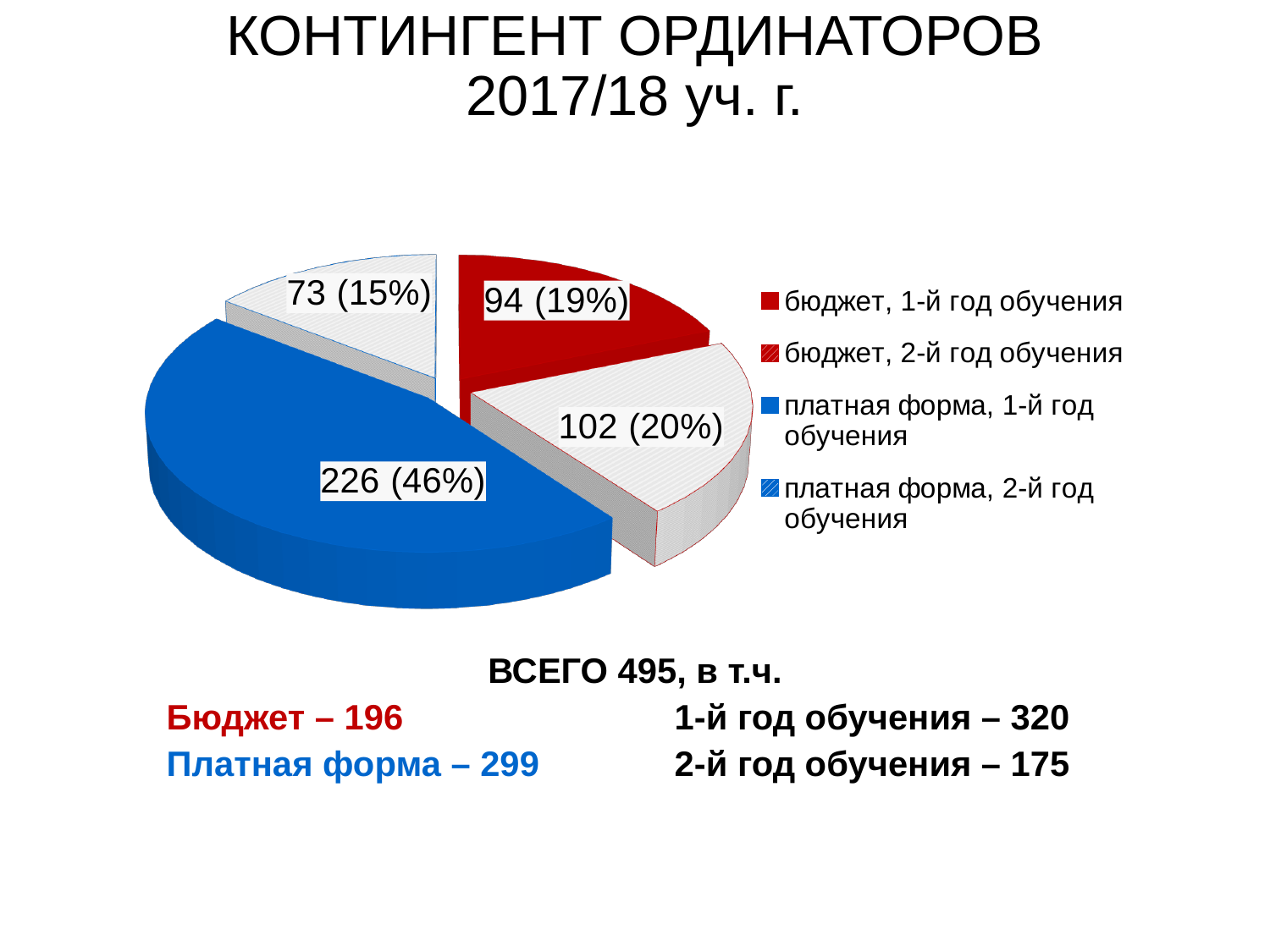
Which is larger: the value for "бюджет, 2-й год обучения" or "бюджет, 1-й год обучения"? бюджет, 2-й год обучения Which category has the largest slice? платная форма, 1-й год обучения How many slices does the pie chart have? 4 Which category has the smallest slice? платная форма, 2-й год обучения What kind of chart is shown on the slide? pie chart What is the value for "платная форма, 2-й год обучения"? 73 What is the difference between the values for "платная форма, 1-й год обучения" and "бюджет, 2-й год обучения"? 124 What share of the pie does "платная форма, 1-й год обучения" take? 46% What is the value for "бюджет, 2-й год обучения"? 102 How many entries does the legend list? 4 What is the value for "бюджет, 1-й год обучения"? 94 What is the value for "платная форма, 1-й год обучения"? 226